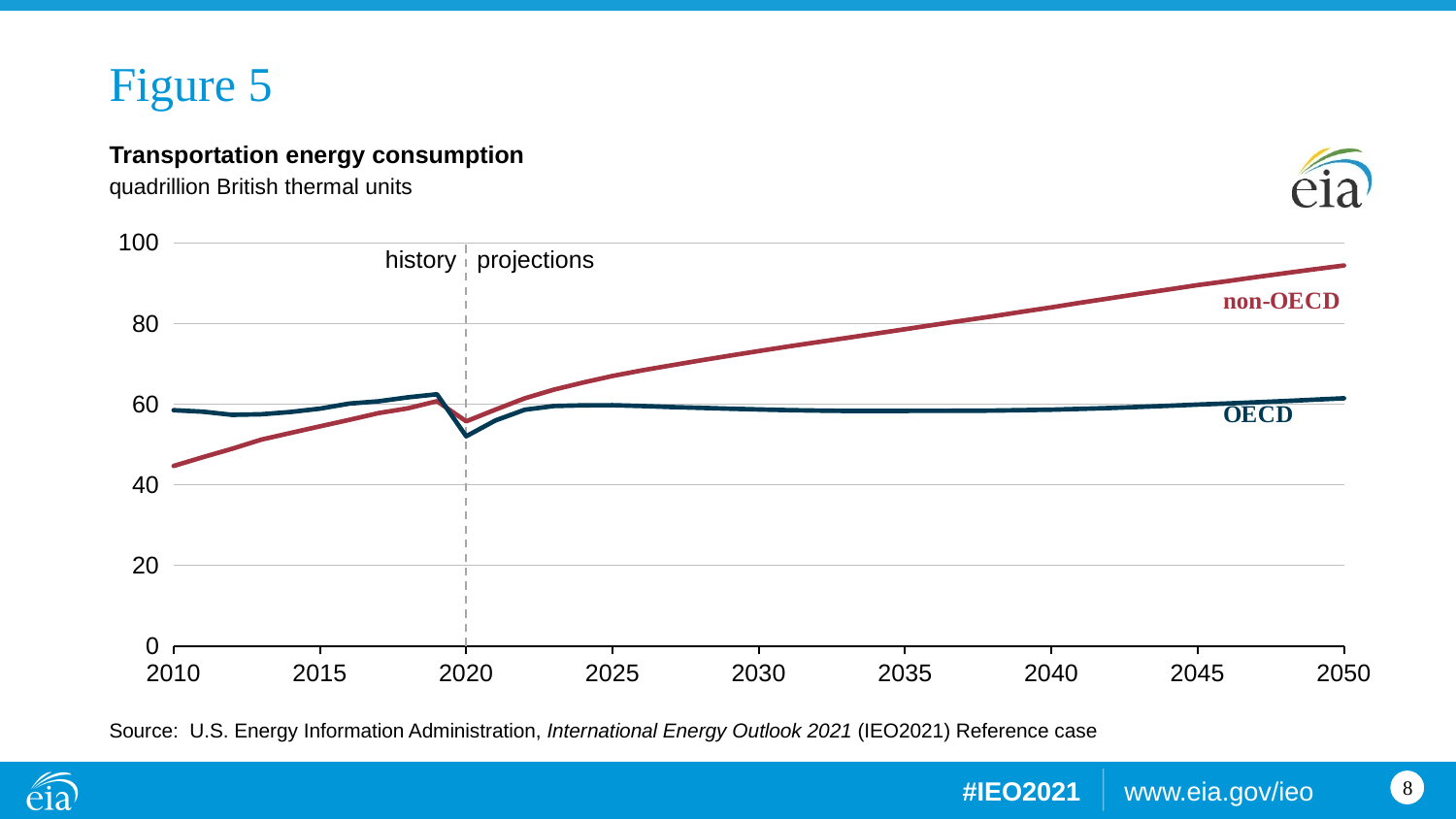
What is the title of the chart? Transportation energy consumption Is the OECD value in 2050 greater or less than 80? less Is the non-OECD value in 2030 greater or less than 60? greater Which series has the higher transportation energy consumption in 2050, non-OECD or OECD? non-OECD Is the non-OECD value in 2010 greater or less than 60? less Which series has the higher transportation energy consumption in 2010, non-OECD or OECD? OECD How many series are plotted on the chart? 2 What kind of chart is shown on the slide? line chart Does the non-OECD line rise or fall between 2020 and 2050? rise In what unit is transportation energy consumption measured on the chart? quadrillion British thermal units